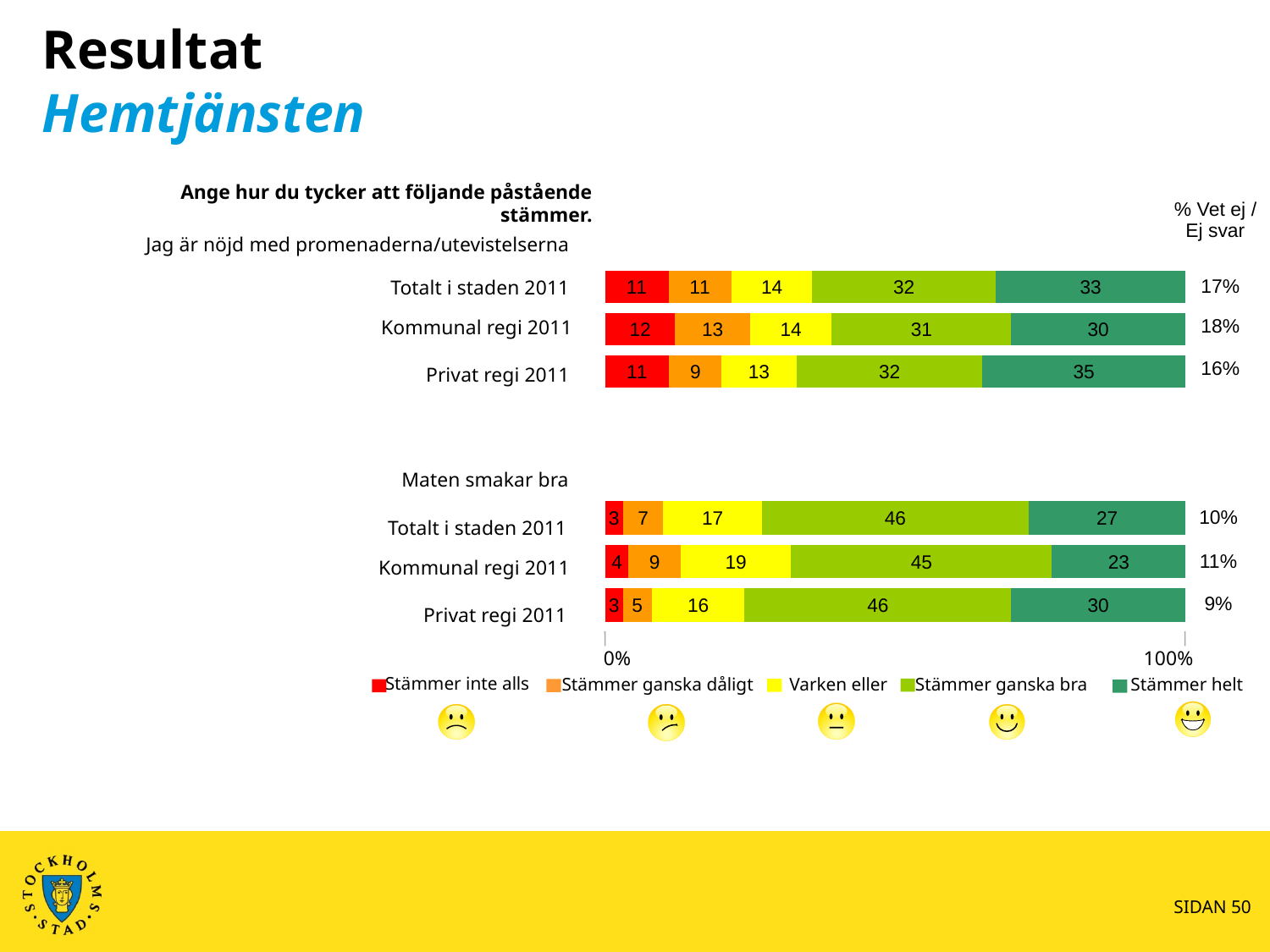
For the statement 'Jag är nöjd med promenaderna/utevistelserna', what is the 'Varken eller' value for Totalt i staden 2011? 14 Which legend entry is shown in red? Stämmer inte alls What kind of chart is shown on the slide? stacked bar chart For the statement 'Maten smakar bra', what is the '% Vet ej / Ej svar' value for Privat regi 2011? 9% For the statement 'Maten smakar bra', which row has the lowest 'Stämmer helt' value? Kommunal regi 2011 For the statement 'Jag är nöjd med promenaderna/utevistelserna', which row has the highest 'Stämmer helt' value? Privat regi 2011 For the statement 'Jag är nöjd med promenaderna/utevistelserna', what is the 'Stämmer helt' value for Privat regi 2011? 35 How many bars (rows) are plotted in total on the slide? 6 For the statement 'Maten smakar bra', what is the difference between the 'Stämmer helt' values for Privat regi 2011 and Kommunal regi 2011? 7 How many series does the legend list? 5 For the statement 'Maten smakar bra', what is the 'Stämmer ganska bra' value for Kommunal regi 2011? 45 For the statement 'Jag är nöjd med promenaderna/utevistelserna', is the 'Stämmer ganska dåligt' value larger for Kommunal regi 2011 or Privat regi 2011? Kommunal regi 2011